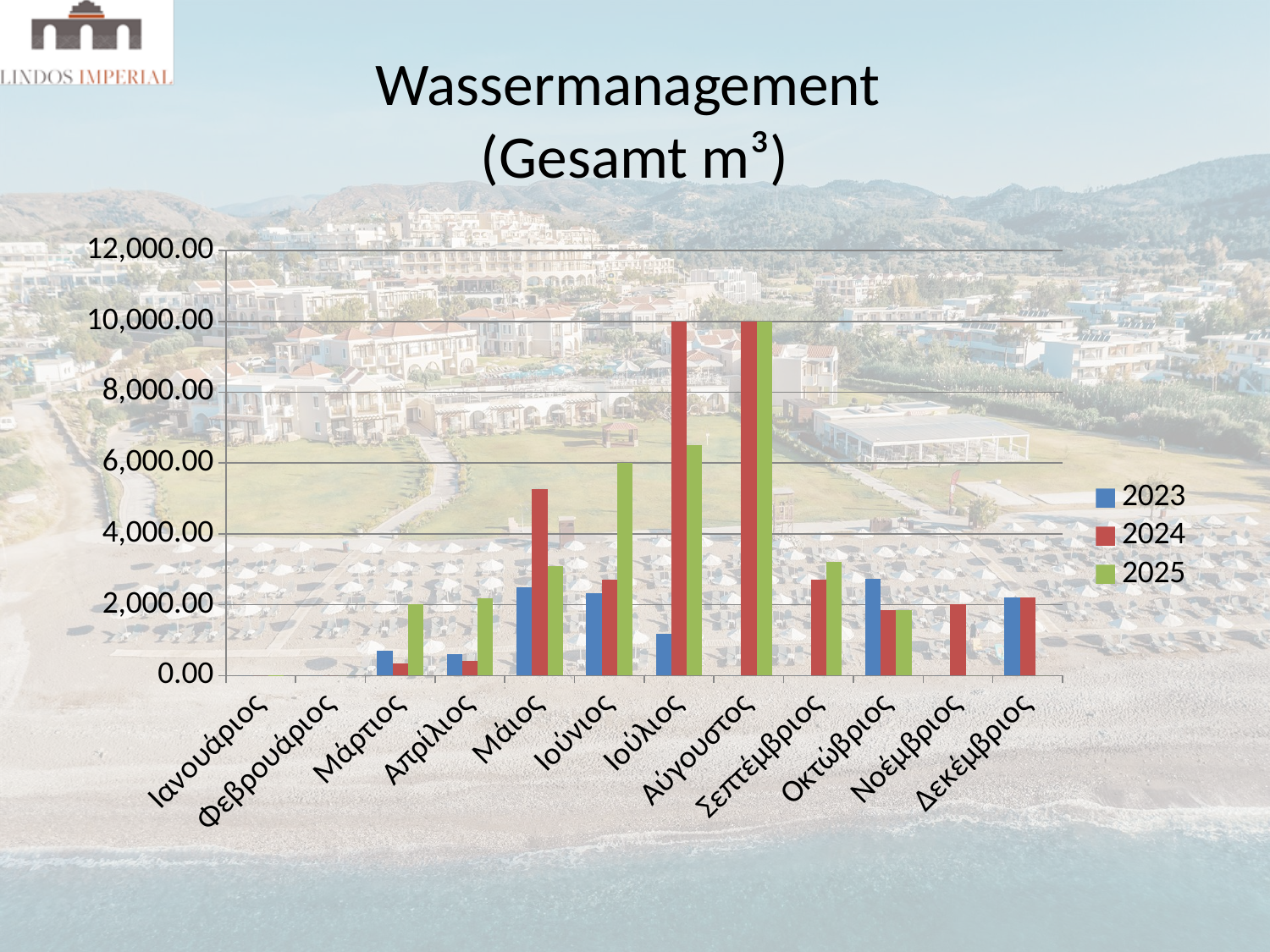
For Ιούλιος, which series has the larger value, 2023 or 2024? 2024 How many months (categories) are shown on the x axis? 12 What is the title of the chart? Wassermanagement (Gesamt m³) How many series does the legend list? 3 Which years are listed in the legend? 2023, 2024, 2025 Is the 2024 value for Μάιος greater or less than 4,000.00? greater What kind of chart is shown on the slide? Bar chart Is the 2025 value for Ιούνιος greater or less than 4,000.00? greater Is the 2025 value for Σεπτέμβριος greater or less than 2,000.00? greater Which month has the highest 2025 value? Αύγουστος For Οκτώβριος, which series has the larger value, 2023 or 2024? 2023